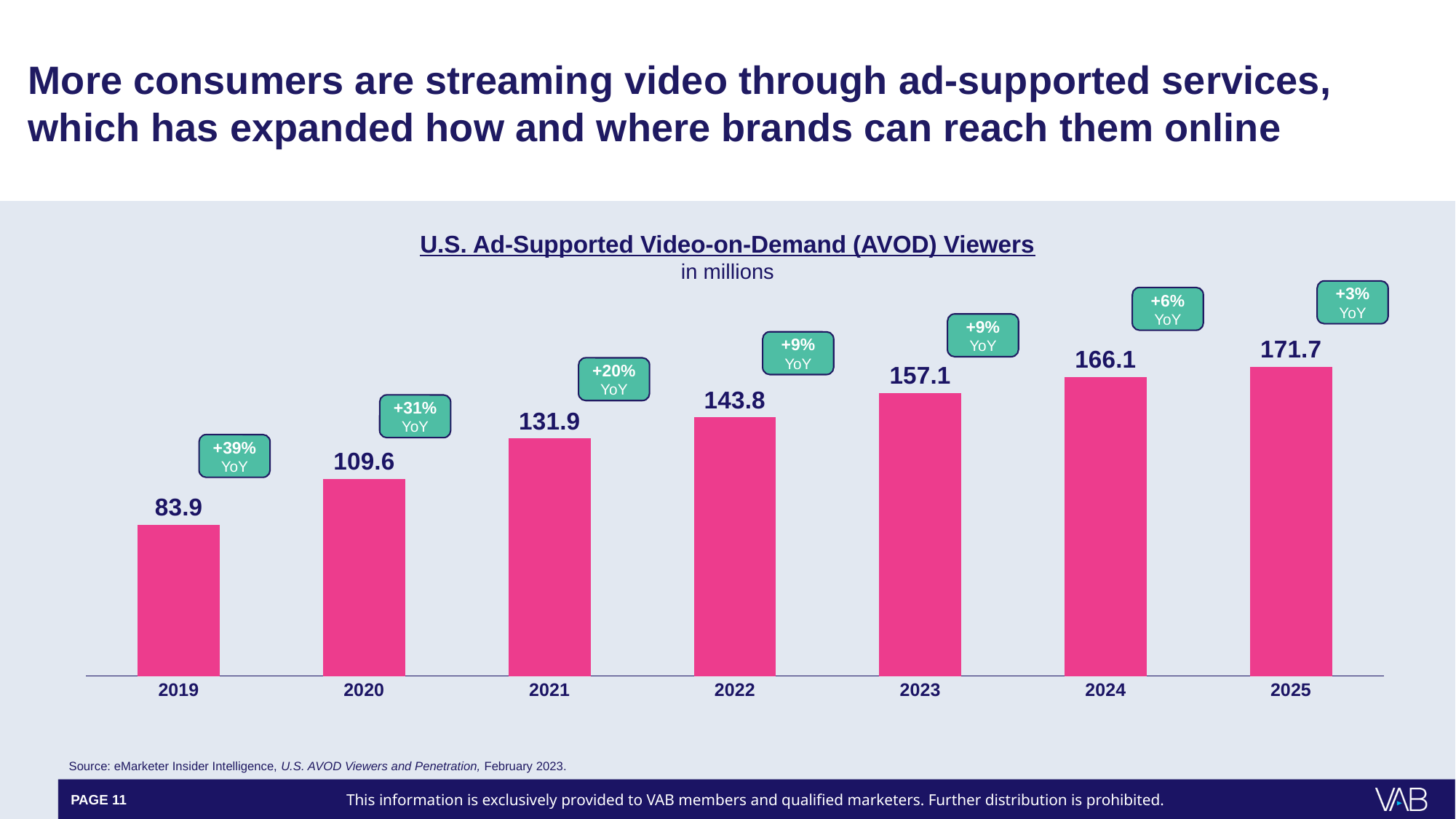
Which is larger in the AVOD Viewers chart, the value for 2021 or the value for 2023? 2023 What is the value for 2019 in the U.S. Ad-Supported Video-on-Demand (AVOD) Viewers chart? 83.9 What is the difference between the 2025 and 2024 values in the AVOD Viewers chart? 5.6 How many years are shown in the AVOD Viewers chart? 7 What is the value for 2022 in the AVOD Viewers chart? 143.8 What is the difference between the 2020 and 2019 values in the AVOD Viewers chart? 25.7 What is the value for 2025 in the AVOD Viewers chart? 171.7 Do the values in the AVOD Viewers chart rise or fall from 2019 to 2025? Rise Which year has the lowest value in the AVOD Viewers chart? 2019 Which year has the highest value in the AVOD Viewers chart? 2025 What year-over-year growth is labeled for 2020 in the AVOD Viewers chart? +31% YoY What kind of chart is used to show U.S. AVOD Viewers? Bar chart